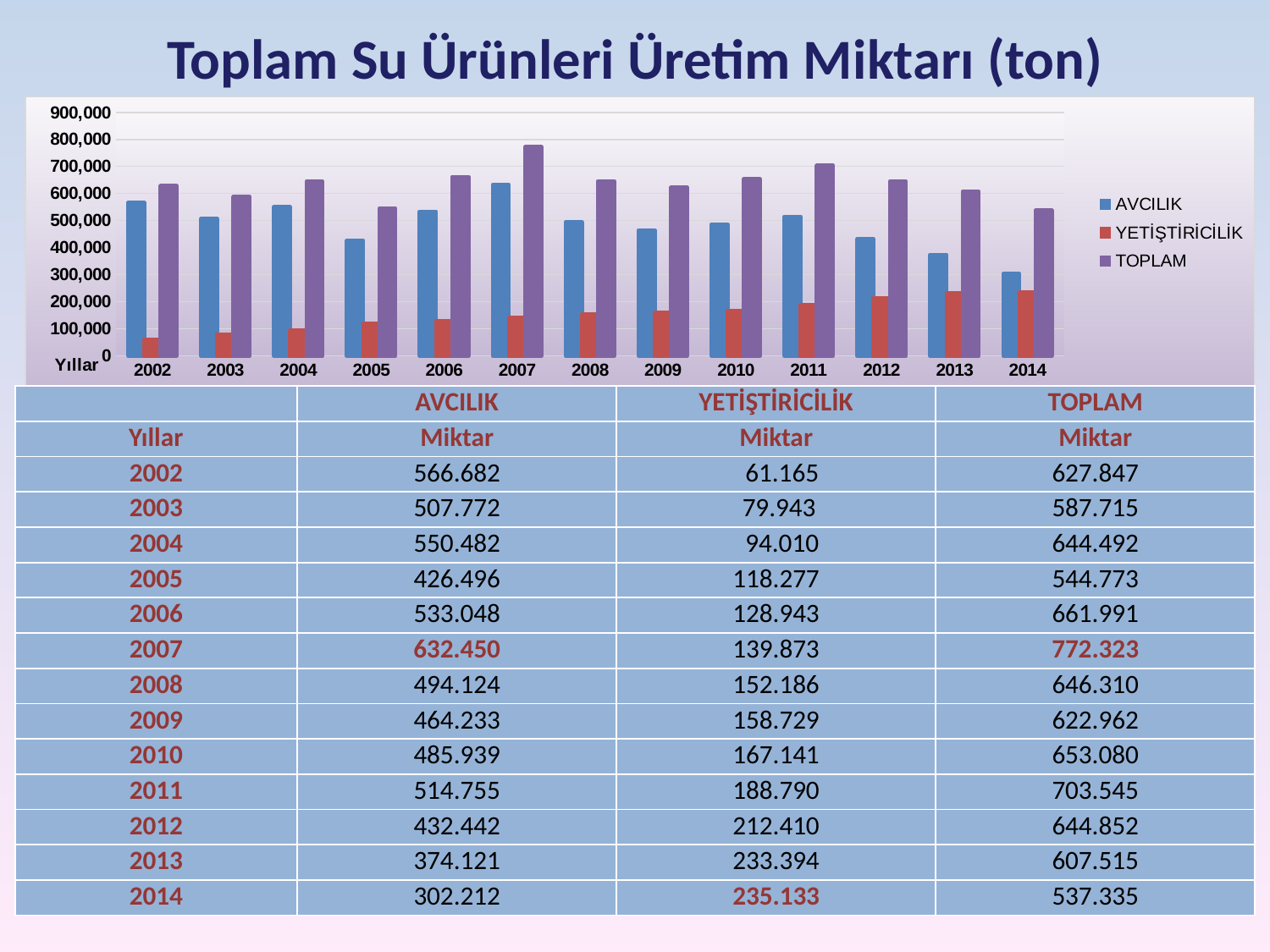
In which year is the TOPLAM value highest? 2007 What is the AVCILIK value for 2007? 632.450 What is the TOPLAM value for 2002? 627.847 Which is larger, the AVCILIK value for 2002 or for 2014? 2002 Is the TOPLAM value for 2007 greater or less than 700,000? greater Does the YETİŞTİRİCİLİK series rise or fall from 2002 to 2014? rise How many years are shown on the x axis of the chart? 13 What kind of chart is shown on the slide? bar chart What is the YETİŞTİRİCİLİK value for 2014? 235.133 What is the difference between the TOPLAM values for 2007 and 2014? 234.988 In which year is the AVCILIK value lowest? 2014 How many series does the chart legend list? 3